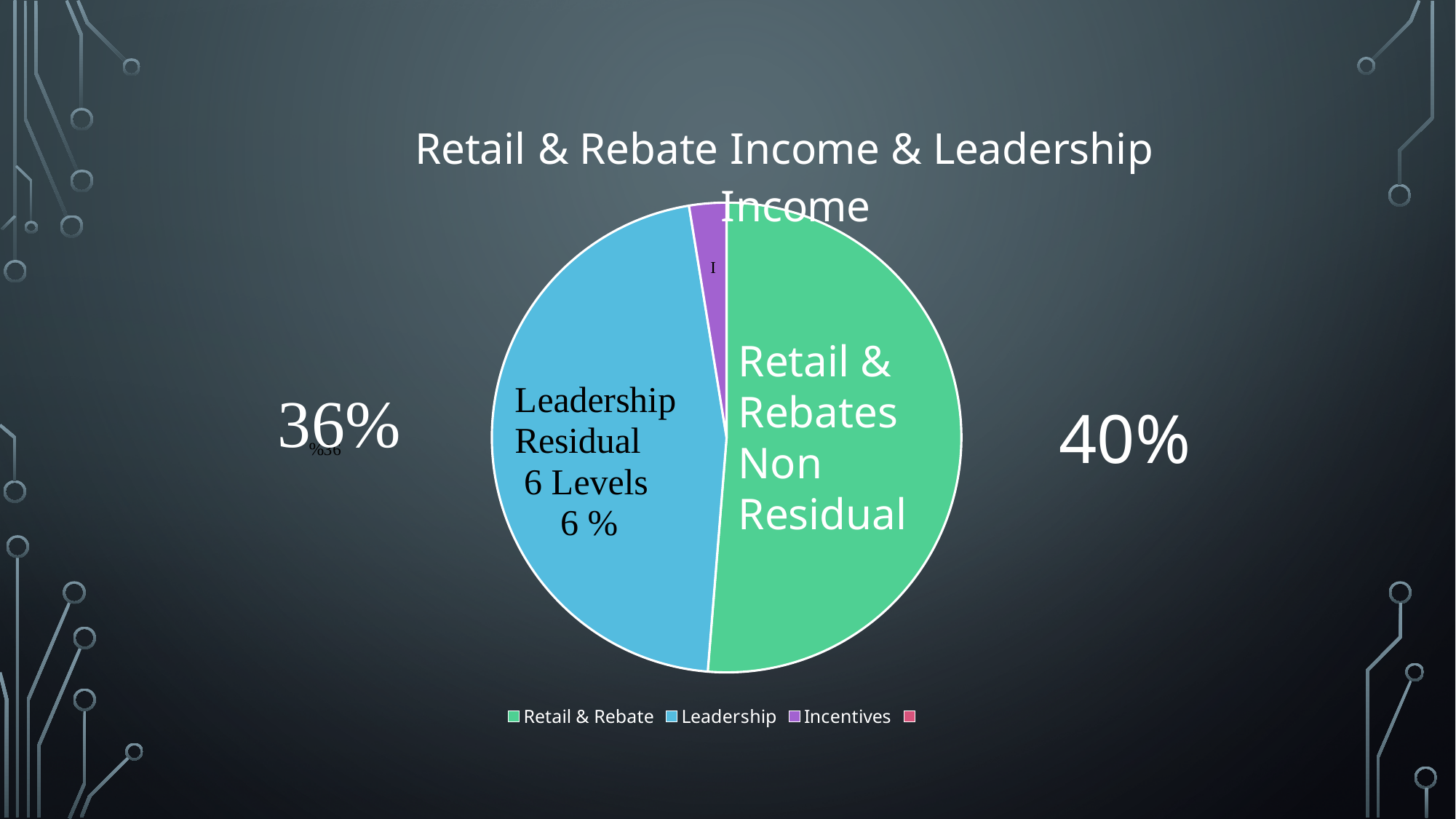
Which slice is larger, Retail & Rebate or Incentives? Retail & Rebate What colour is the Leadership slice? blue Which slice is larger, Leadership or Incentives? Leadership What kind of chart is shown on the slide? pie chart How many labelled entries does the legend list? 3 Which legend entry is shown in green? Retail & Rebate What is the title of the chart? Retail & Rebate Income & Leadership Income How many slices are visible in the pie chart? 3 Which slice of the pie is the largest? Retail & Rebate Which slice of the pie is the smallest? Incentives